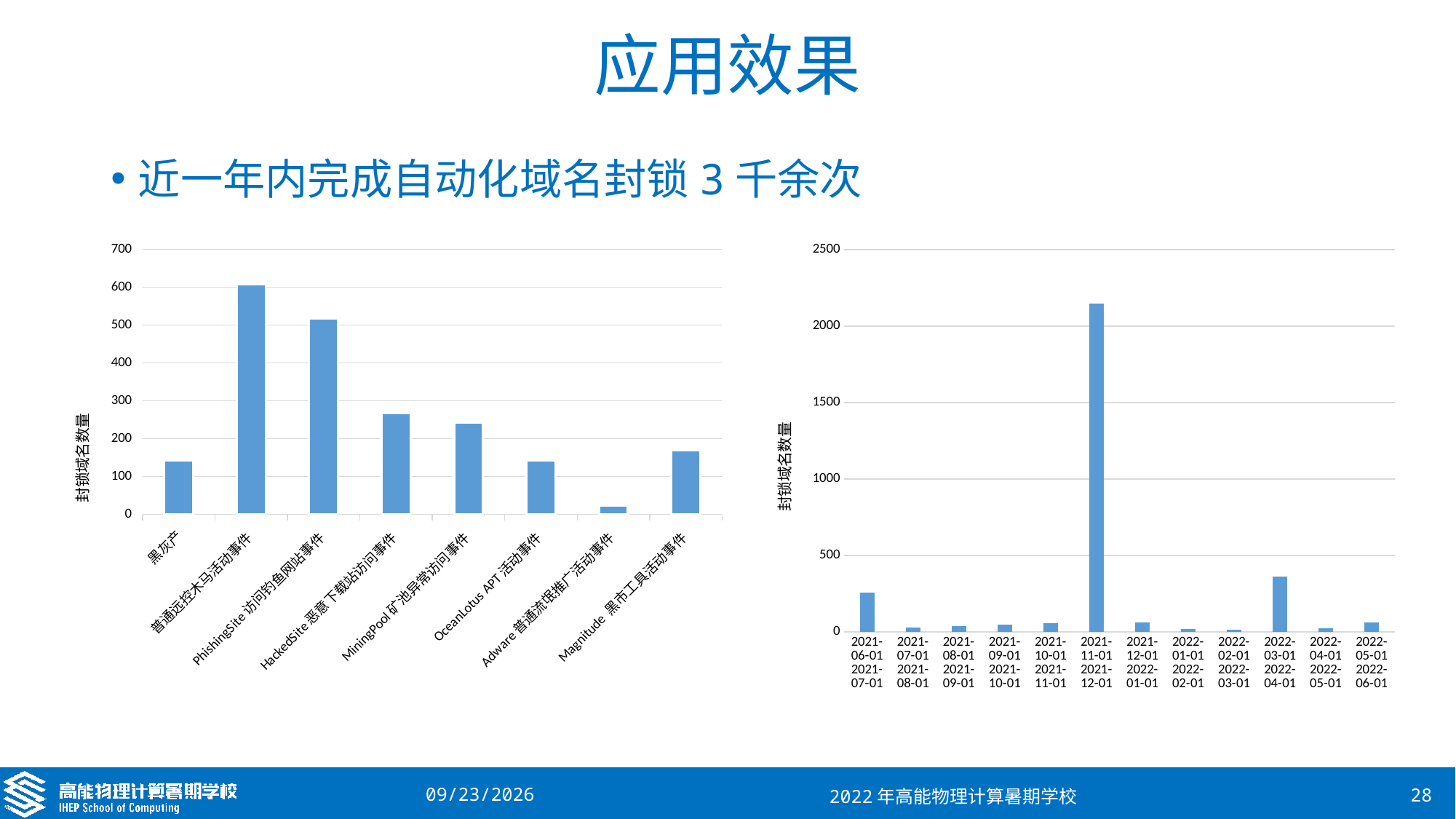
In the left chart, is the value for Adware 普通流氓推广活动事件 greater or less than 100? less In the right chart, how many time periods are shown on the x axis? 12 In the left chart, which category has the lowest value? Adware 普通流氓推广活动事件 In the left chart, which category has the highest value? 普通远控木马活动事件 In the left chart, how many categories are shown on the x axis? 8 In the right chart, is the value for the period 2021-11-01 to 2021-12-01 greater or less than 2000? greater In the right chart, which period has the highest value? 2021-11-01 to 2021-12-01 What is the y-axis label of the right chart? 封锁域名数量 In the left chart, is the value for PhishingSite 访问钓鱼网站事件 greater or less than 400? greater In the left chart, which is larger: PhishingSite 访问钓鱼网站事件 or HackedSite 恶意下载站访问事件? PhishingSite 访问钓鱼网站事件 In the right chart, which is larger: the period 2022-03-01 to 2022-04-01 or the period 2021-06-01 to 2021-07-01? 2022-03-01 to 2022-04-01 What kind of chart is the left chart on the slide? bar chart